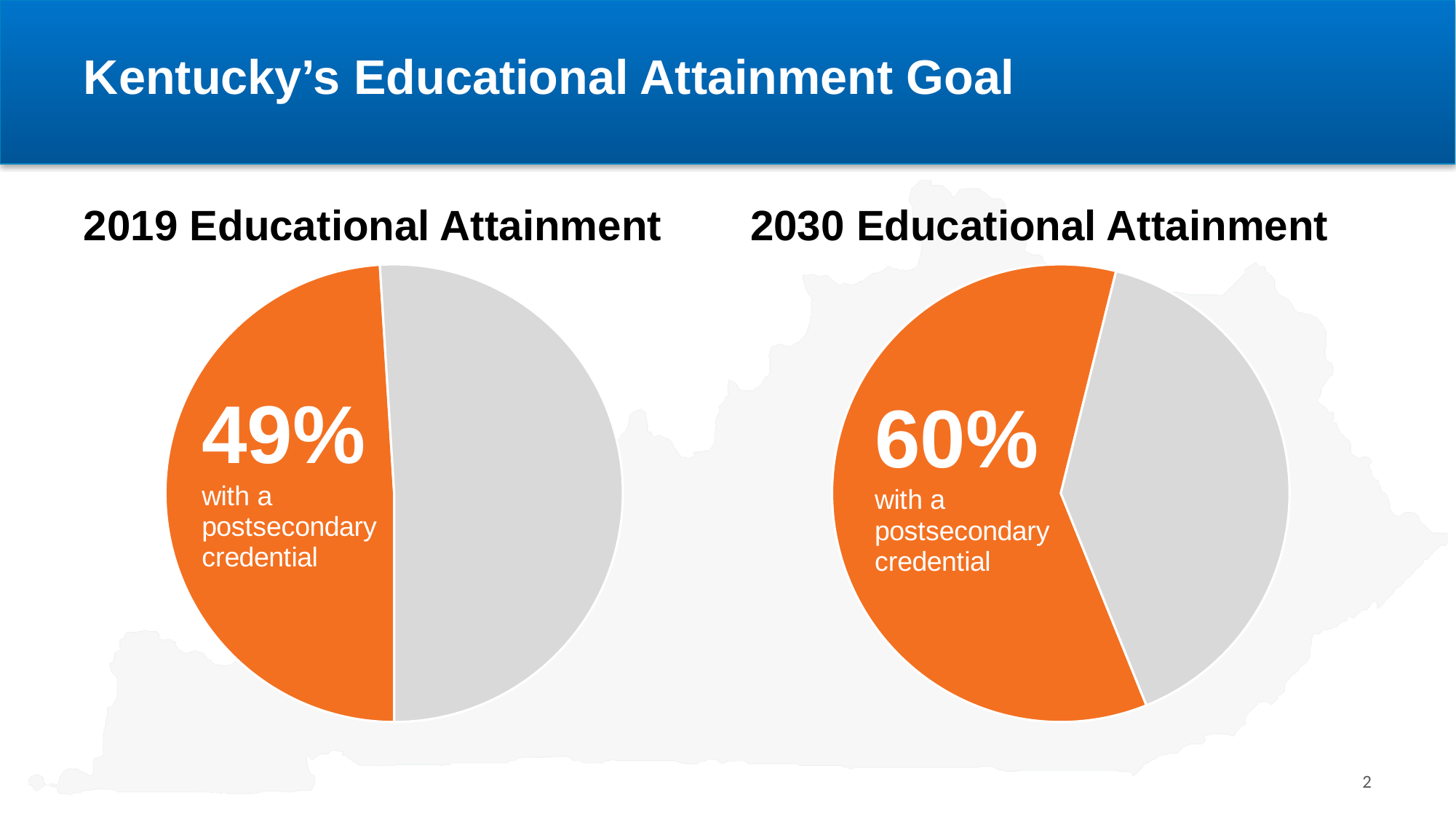
What is the difference in percentage points between the postsecondary credential share in the 2030 Educational Attainment chart and the 2019 Educational Attainment chart? 11 percentage points Which chart shows a larger share with a postsecondary credential, the 2019 Educational Attainment chart or the 2030 Educational Attainment chart? 2030 Educational Attainment How many slices does the 2030 Educational Attainment pie chart have? 2 In the 2019 Educational Attainment chart, is the share with a postsecondary credential greater or less than 50%? less How many slices does the 2019 Educational Attainment pie chart have? 2 In the 2030 Educational Attainment chart, is the share with a postsecondary credential greater or less than 50%? greater In the 2019 Educational Attainment chart, what percentage of the population has a postsecondary credential? 49% What kind of chart is the 2030 Educational Attainment chart? Pie chart What is the title of the slide containing the two pie charts? Kentucky's Educational Attainment Goal What colour is the slice representing people with a postsecondary credential in the 2019 Educational Attainment chart? Orange What kind of chart is the 2019 Educational Attainment chart? Pie chart In the 2030 Educational Attainment chart, what percentage of the population has a postsecondary credential? 60%